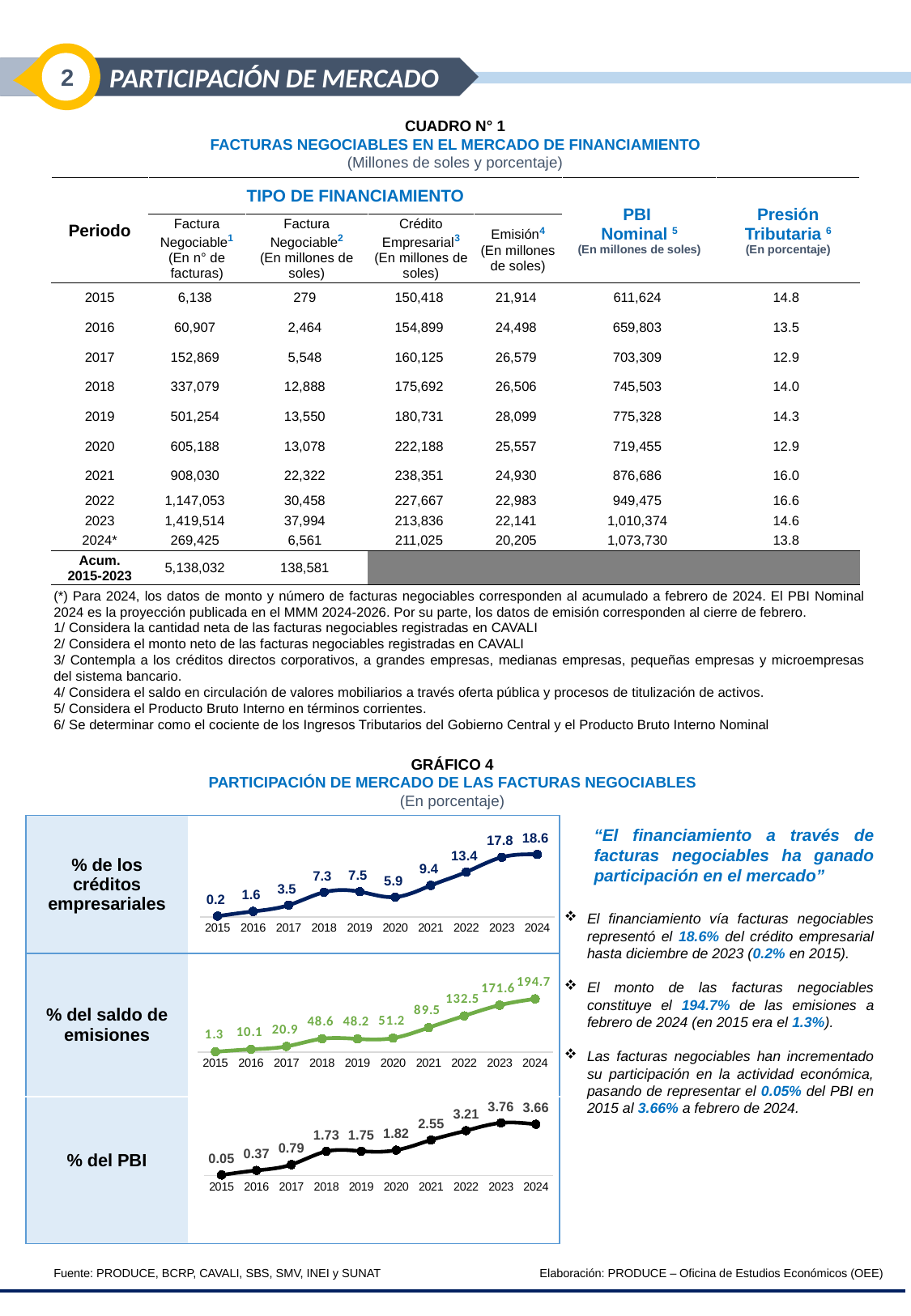
What is the title of Gráfico 4? Participación de mercado de las facturas negociables In Gráfico 4, which year has the highest value in the '% del PBI' chart? 2023 In Gráfico 4, what is the value for 2024 in the '% de los créditos empresariales' chart? 18.6 In Gráfico 4, which year has the lowest value in the '% del PBI' chart? 2015 In Gráfico 4, how many years are plotted in the '% del PBI' chart? 10 What kind of chart is used in Gráfico 4 for '% de los créditos empresariales'? Line chart In Gráfico 4, what is the value for 2021 in the '% del PBI' chart? 2.55 In Gráfico 4, what is the difference between the 2024 and 2015 values in the '% de los créditos empresariales' chart? 18.4 In Gráfico 4, what is the value for 2015 in the '% del saldo de emisiones' chart? 1.3 In Gráfico 4, in the '% del saldo de emisiones' chart, is the value for 2018 or 2019 larger? 2018 In Gráfico 4, which year has the highest value in the '% del saldo de emisiones' chart? 2024 In Gráfico 4, do the values in the '% del saldo de emisiones' chart generally rise or fall from 2015 to 2024? Rise